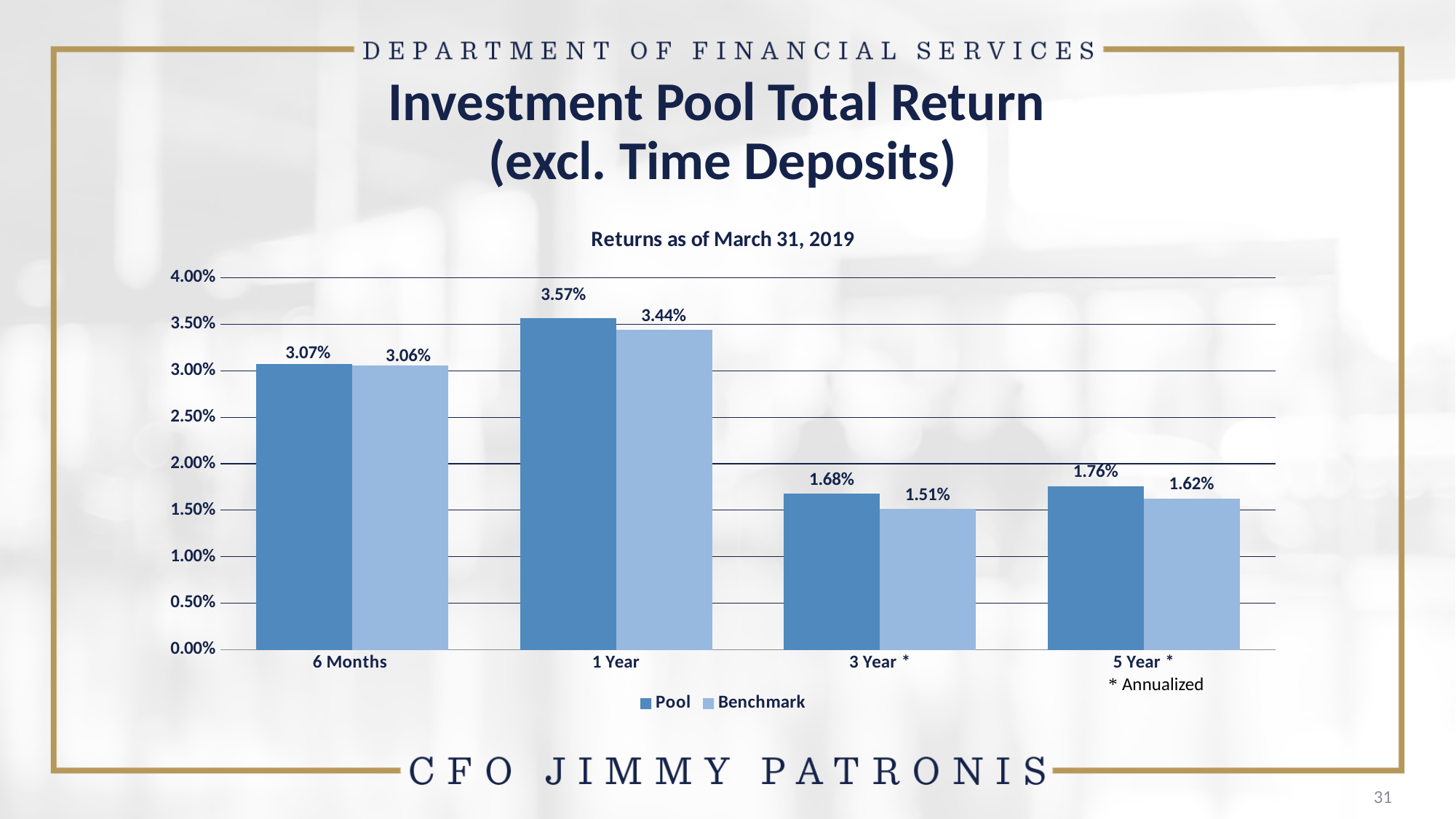
What is the Benchmark return for 3 Year? 1.51% What is the difference between the Pool and Benchmark returns for 1 Year? 0.13% What kind of chart is shown on the slide? Bar chart Which is larger for 3 Year, the Pool return or the Benchmark return? Pool What is the Pool return for 1 Year? 3.57% Which period has the highest Pool return? 1 Year What is the Benchmark return for 6 Months? 3.06% How many series does the legend list? 2 How many periods are shown on the x axis? 4 Which period has the lowest Benchmark return? 3 Year What is the Pool return for 5 Year? 1.76% What is the subtitle shown above the chart? Returns as of March 31, 2019